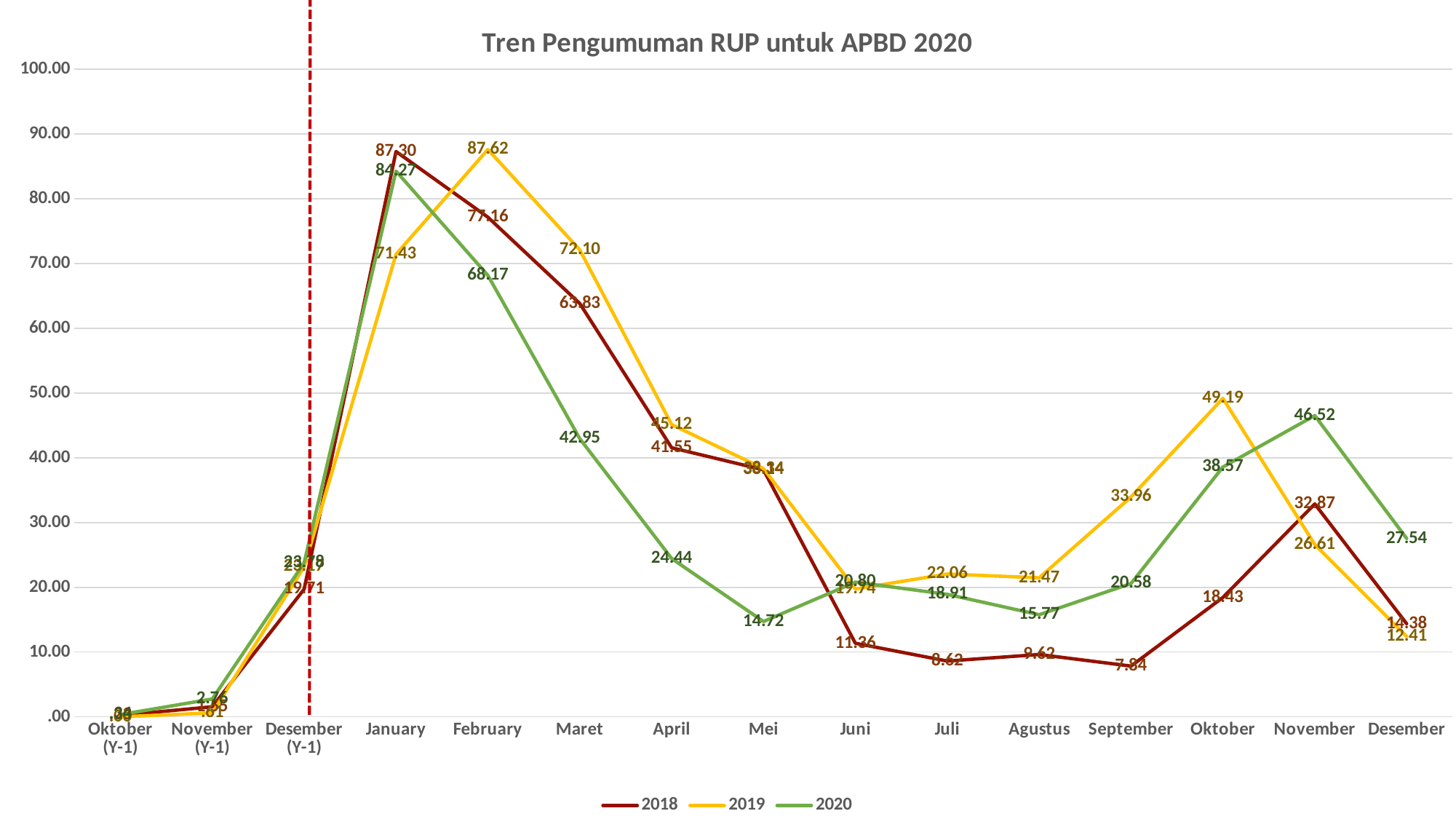
How many series does the legend list? 3 What is the value for 2020 in November? 46.52 Is the value for 2020 in April greater or less than 30.00? less What kind of chart is shown on the slide? line chart How many categories are shown on the x axis? 15 What is the title of the chart? Tren Pengumuman RUP untuk APBD 2020 What is the value for 2019 in February? 87.62 What is the value for 2018 in September? 7.84 Which series has the larger value in Maret, 2018 or 2020? 2018 What is the difference between the 2019 and 2020 values in Oktober? 10.62 In which month does the 2018 series reach its highest value? January In which month does the 2019 series reach its highest value? February